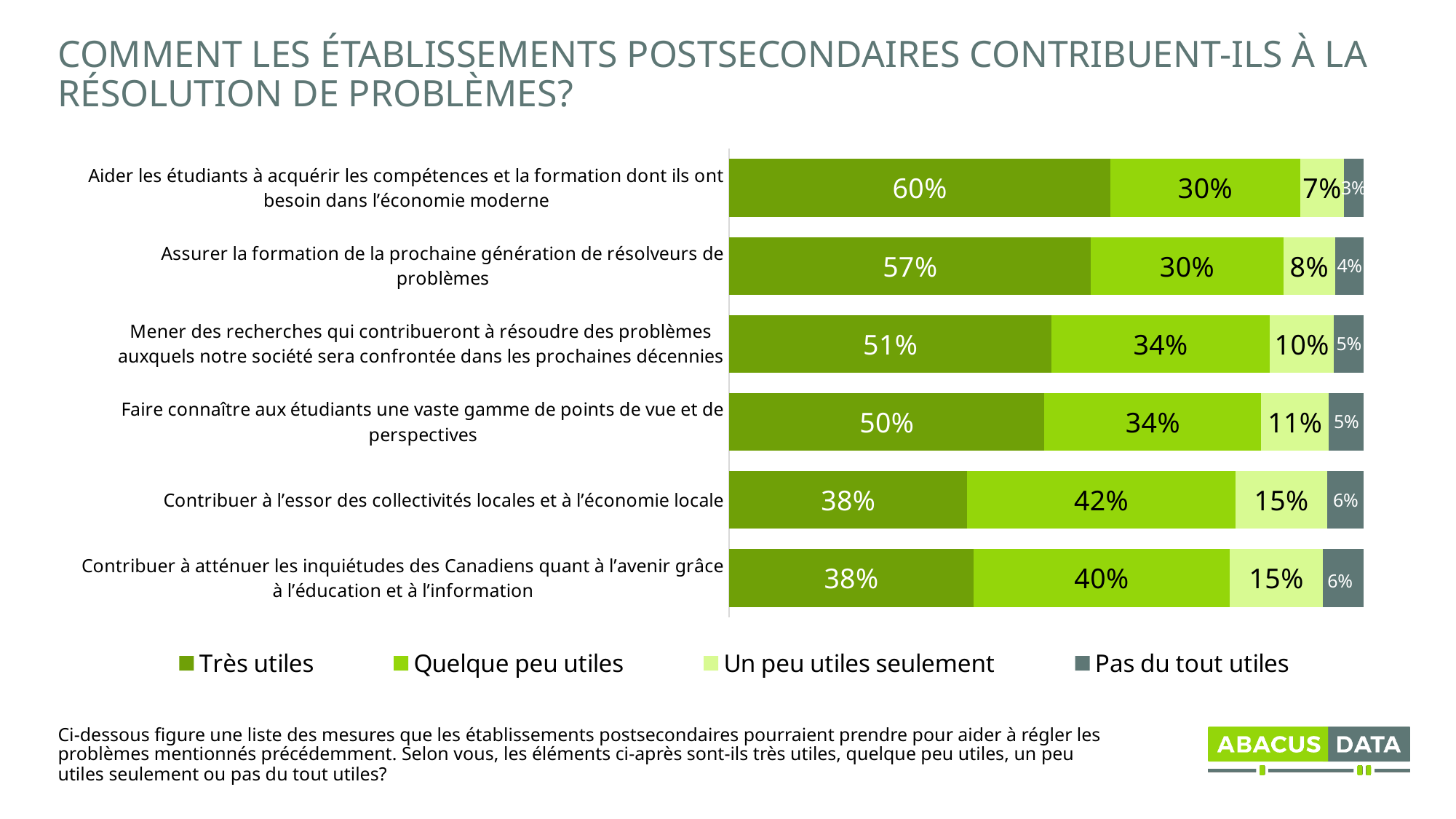
Which category has the highest 'Très utiles' value? Aider les étudiants à acquérir les compétences et la formation dont ils ont besoin dans l'économie moderne Which category has the lowest 'Pas du tout utiles' value? Aider les étudiants à acquérir les compétences et la formation dont ils ont besoin dans l'économie moderne What is the difference between the 'Très utiles' values for 'Aider les étudiants à acquérir les compétences...' and 'Assurer la formation de la prochaine génération de résolveurs de problèmes'? 3 percentage points How many categories (measures) are plotted in the chart? 6 What is the 'Un peu utiles seulement' value for 'Faire connaître aux étudiants une vaste gamme de points de vue et de perspectives'? 11% What is the total of the stacked bar for 'Assurer la formation de la prochaine génération de résolveurs de problèmes'? 99% Which is larger: the 'Quelque peu utiles' value for 'Contribuer à l'essor des collectivités locales et à l'économie locale' or for 'Contribuer à atténuer les inquiétudes des Canadiens quant à l'avenir grâce à l'éducation et à l'information'? Contribuer à l'essor des collectivités locales et à l'économie locale What kind of chart is shown on the slide? Stacked bar chart How many series does the legend list? 4 What is the 'Quelque peu utiles' value for 'Contribuer à l'essor des collectivités locales et à l'économie locale'? 42% What is the 'Très utiles' value for 'Aider les étudiants à acquérir les compétences et la formation dont ils ont besoin dans l'économie moderne'? 60% What is the 'Pas du tout utiles' value for 'Mener des recherches qui contribueront à résoudre les problèmes auxquels notre société sera confrontée dans les prochaines décennies'? 5%